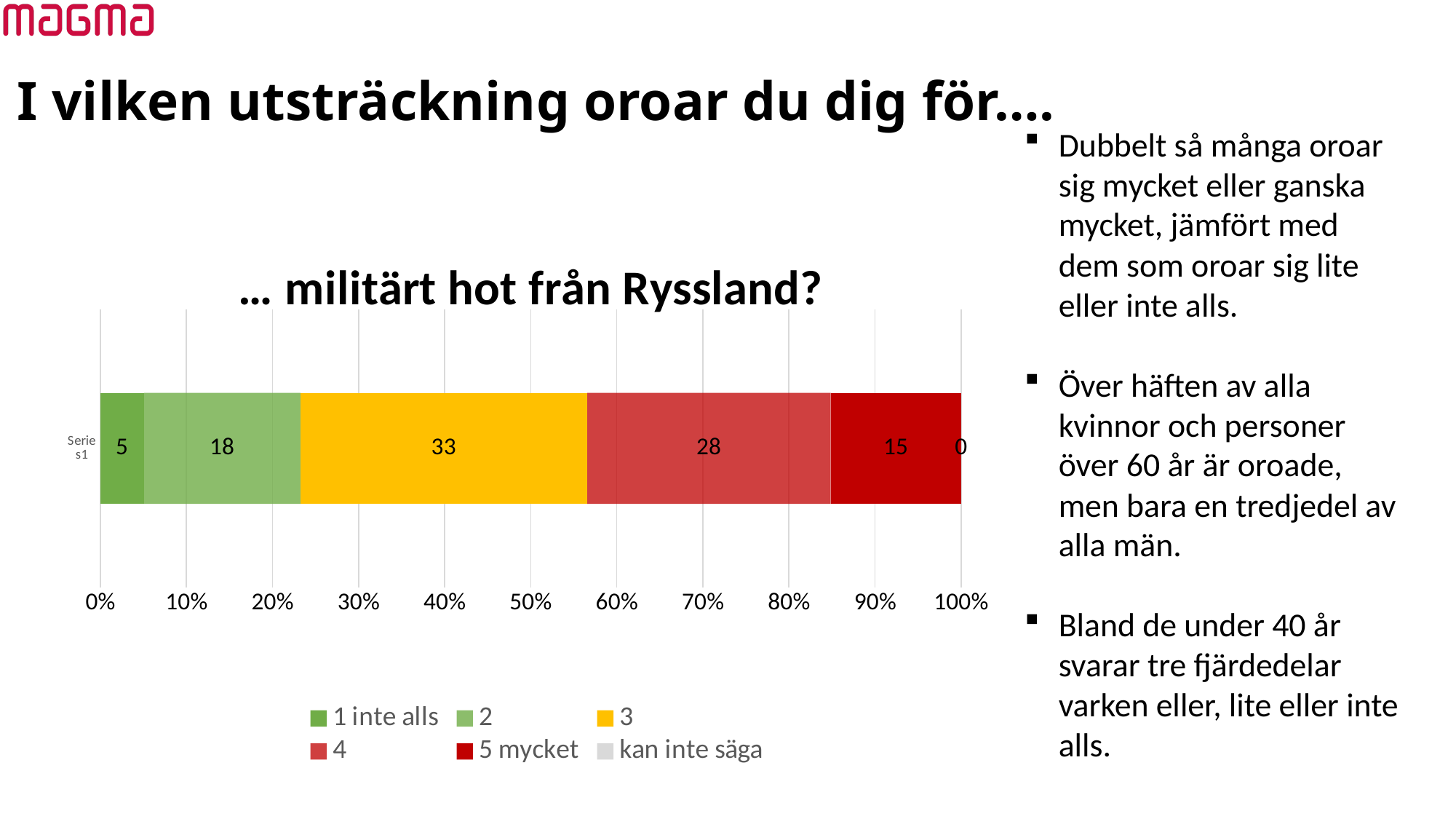
How many series does the legend list? 6 What kind of chart is shown on the slide? Stacked bar chart What is the title of the chart? … militärt hot från Ryssland? What is the value for the "5 mycket" segment in the chart? 15 What is the difference between the "3" segment and the "4" segment? 5 Which is larger, the "2" segment or the "5 mycket" segment? 2 Which legend entry has the smallest segment in the bar? kan inte säga What is the value for the "kan inte säga" segment in the chart? 0 What is the value for the "1 inte alls" segment in the chart? 5 What is the total of all segments in the stacked bar? 99 What is the value for the "3" segment in the chart? 33 Which legend entry has the largest segment in the bar? 3